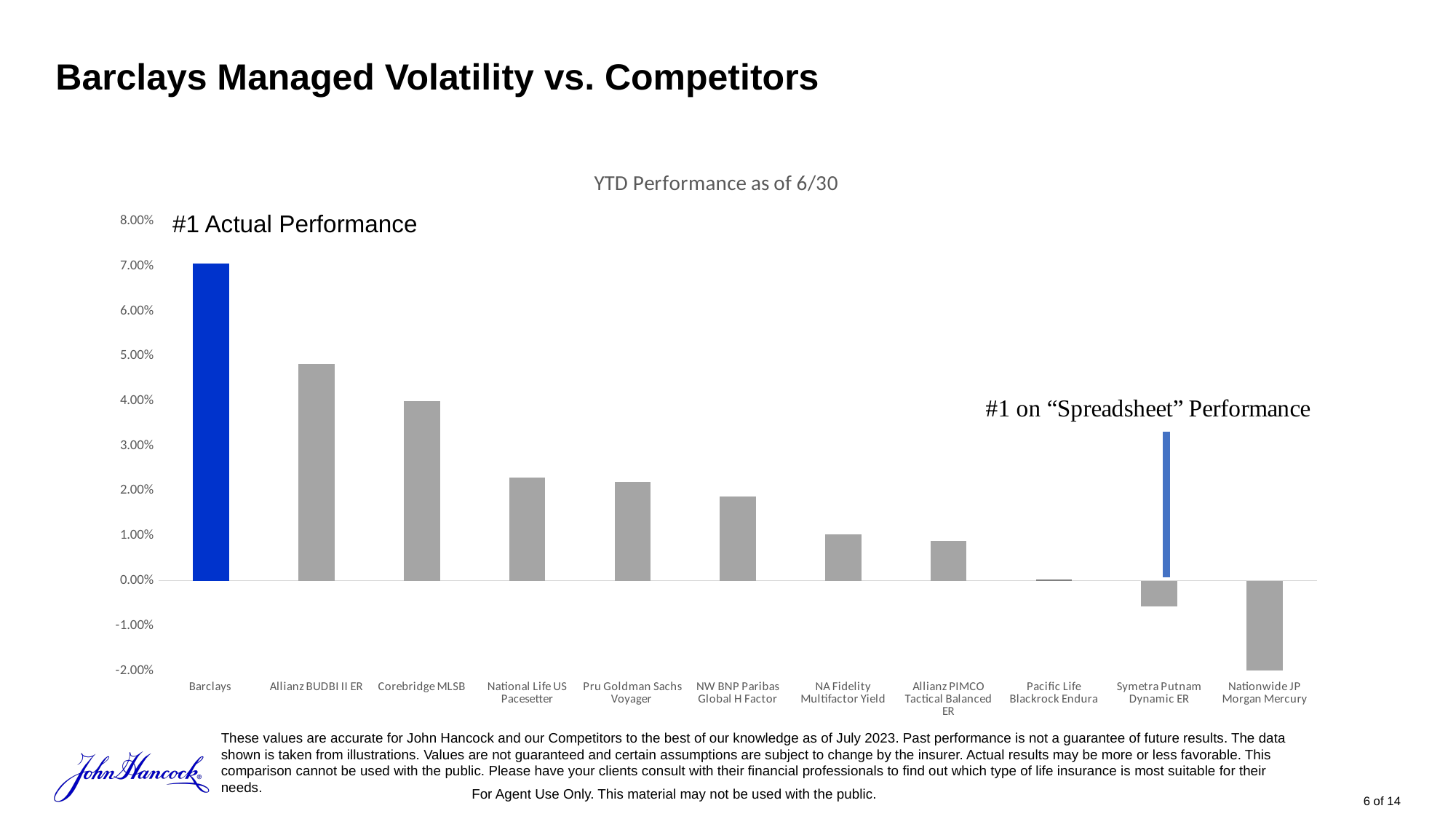
Which category has the lowest YTD performance? Nationwide JP Morgan Mercury How many categories (products) are plotted in the chart? 11 What is the title of the chart? YTD Performance as of 6/30 What colour is the Barclays bar? Blue Is the value for Allianz BUDBI II ER greater or less than 4.00%? greater Do the bar values generally rise or fall moving from left to right across the chart? Fall Which category has the highest YTD performance? Barclays What type of chart is shown on the slide? Bar chart Is the value for National Life US Pacesetter greater or less than 3.00%? less Which is larger, the value for Corebridge MLSB or the value for National Life US Pacesetter? Corebridge MLSB Is the value for Nationwide JP Morgan Mercury greater or less than -1.00%? less